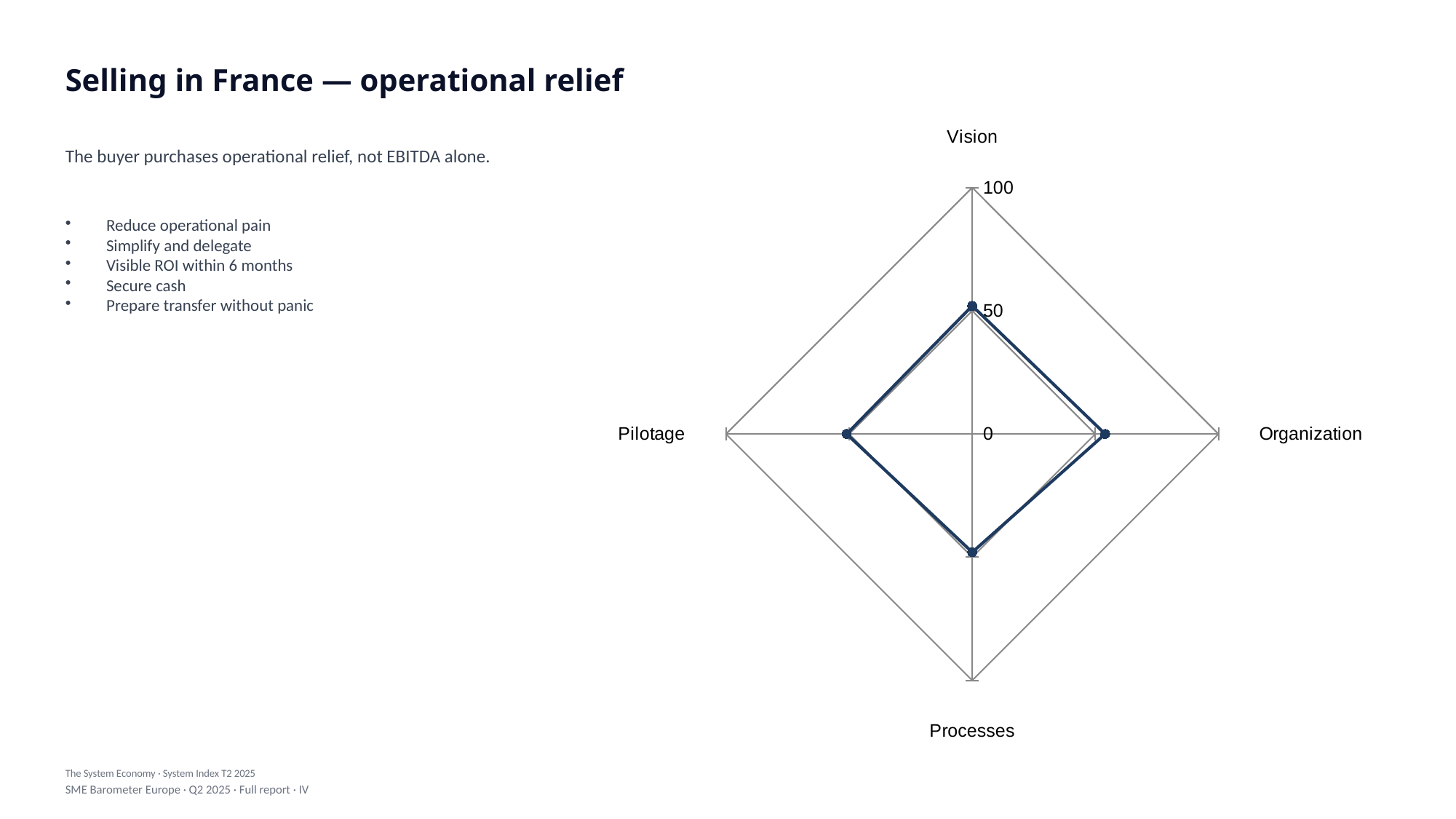
What kind of chart is shown on the slide? Radar chart Is the value for Pilotage greater or less than 0? greater Is the value for Vision greater or less than 100? less Which category is at the top of the radar chart? Vision What is the maximum value shown on the radar chart's axis scale? 100 Is the value for Processes greater or less than 100? less Which category is on the left side of the radar chart? Pilotage How many categories (axes) does the radar chart have? 4